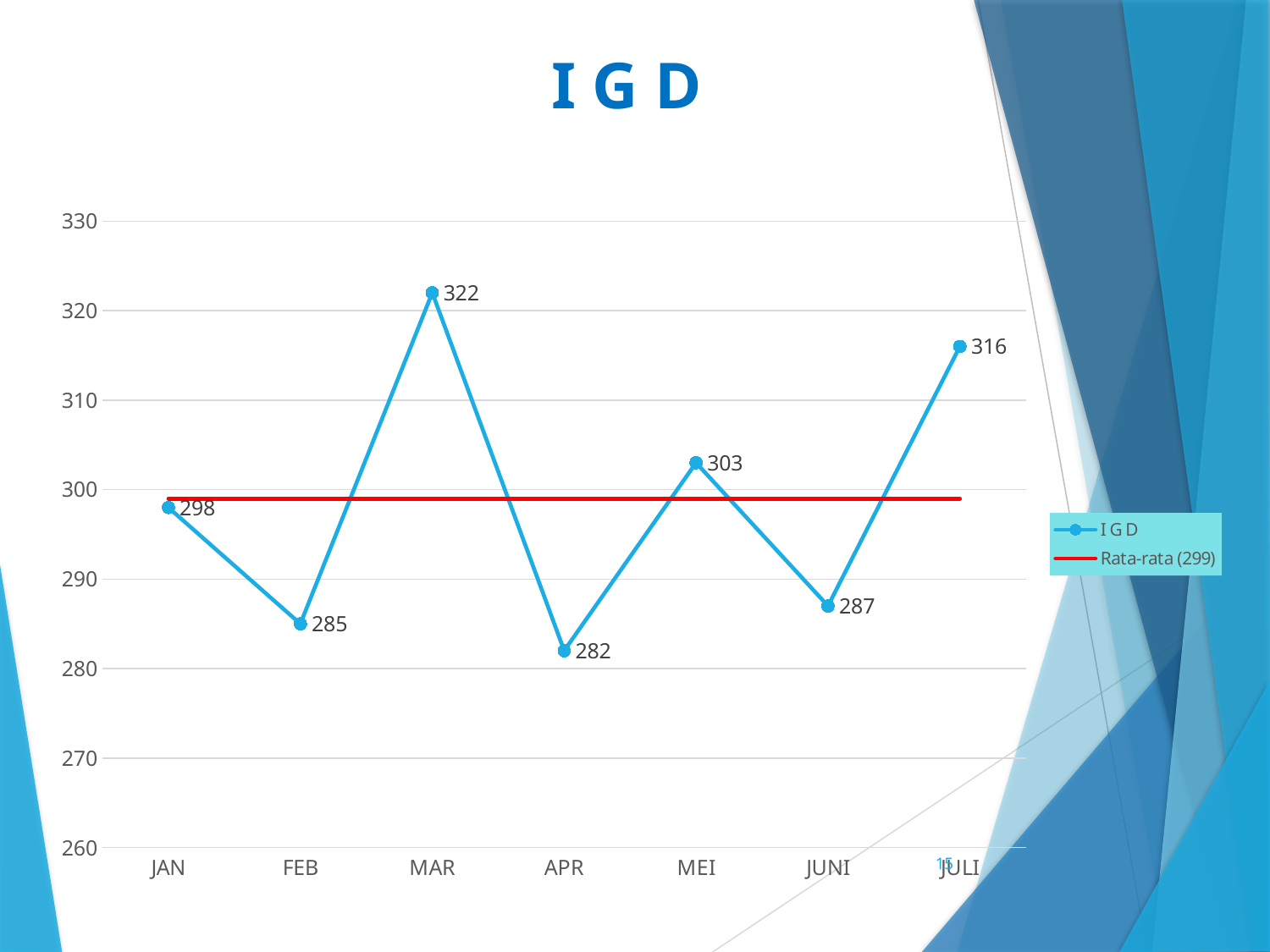
What value does the red Rata-rata line represent according to the legend? 299 What is the I G D value for MAR? 322 What is the I G D value for JULI? 316 Which is larger, the I G D value for JAN or for FEB? JAN How many series does the legend list? 2 What is the I G D value for APR? 282 Which month has the lowest I G D value? APR What is the difference between the I G D values for MAR and APR? 40 How many months are plotted on the x axis? 7 What kind of chart is shown on the slide? line chart Which month has the highest I G D value? MAR Is the I G D value for JUNI greater or less than 290? less